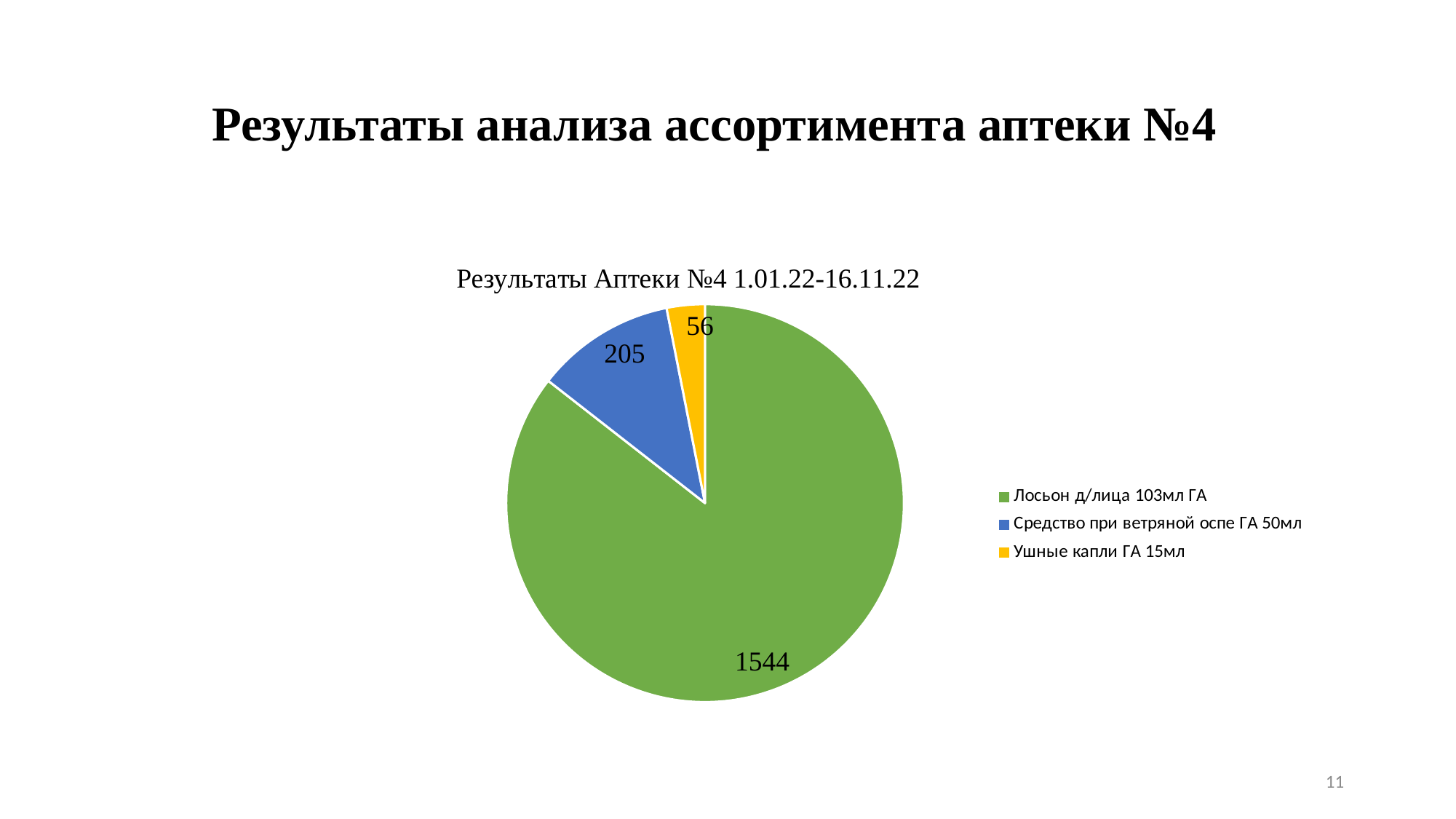
What is the total of all the slices in the pie chart? 1805 What is the value for Лосьон д/лица 103мл ГА? 1544 Which is larger, the value for Средство при ветряной оспе ГА 50мл or the value for Ушные капли ГА 15мл? Средство при ветряной оспе ГА 50мл What is the value for Средство при ветряной оспе ГА 50мл? 205 What is the title of the chart? Результаты Аптеки №4 1.01.22-16.11.22 Which category has the smallest slice of the pie? Ушные капли ГА 15мл How many categories are shown in the pie chart? 3 What is the value for Ушные капли ГА 15мл? 56 What is the difference between the values for Лосьон д/лица 103мл ГА and Средство при ветряной оспе ГА 50мл? 1339 What is the difference between the values for Средство при ветряной оспе ГА 50мл and Ушные капли ГА 15мл? 149 Which category has the largest slice of the pie? Лосьон д/лица 103мл ГА What kind of chart is shown on the slide? Pie chart